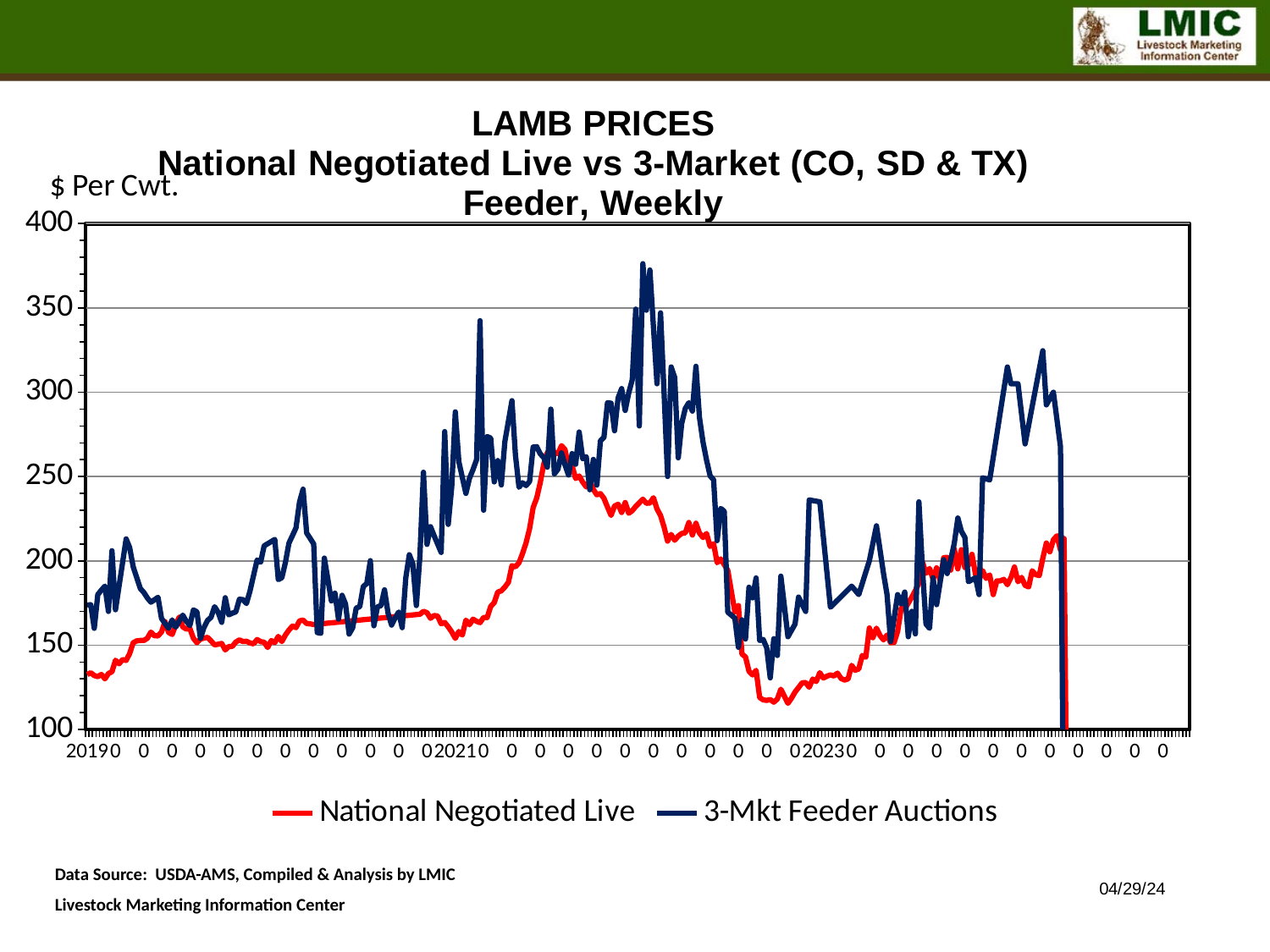
What unit is shown on the y-axis label? $ Per Cwt. Does the National Negotiated Live series rise or fall between the start of 2019 and the start of 2021? rise Which series has the higher value at the start of 2019, National Negotiated Live or 3-Mkt Feeder Auctions? 3-Mkt Feeder Auctions Which series reaches the highest peak on the chart? 3-Mkt Feeder Auctions Is the value of the National Negotiated Live series at the start of 2019 greater or less than 150? less Is the highest value of the National Negotiated Live series greater or less than 300? less How many series does the legend list? 2 What kind of chart is shown on the slide? Line chart Is the lowest value of the National Negotiated Live series greater or less than 150? less What are the two series named in the legend? National Negotiated Live and 3-Mkt Feeder Auctions What is the maximum value shown on the y-axis? 400